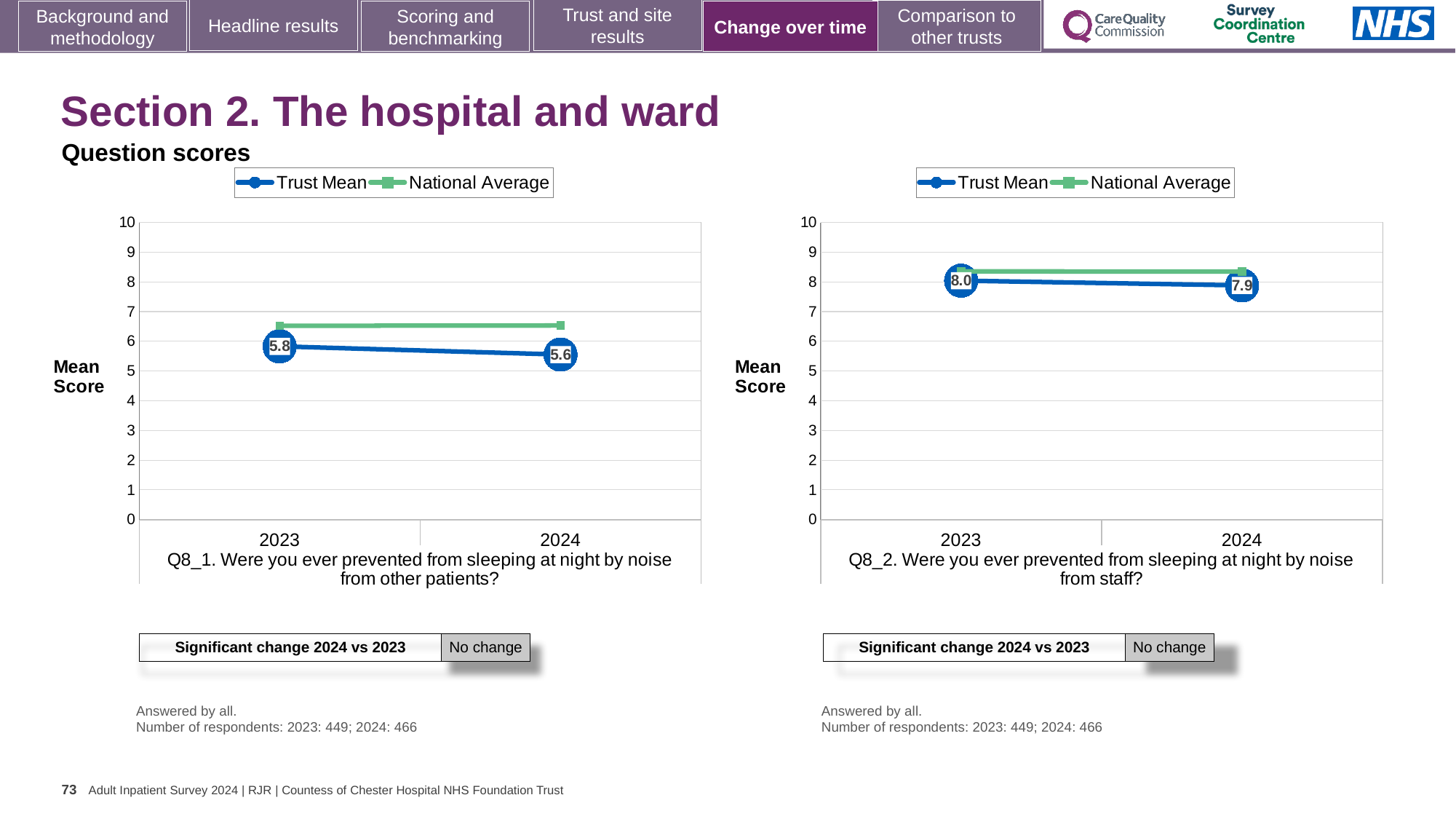
In the Q8_1 chart (left), is the National Average for 2024 greater or less than 6? greater In the Q8_1 chart (left), by how much did the Trust Mean change from 2023 to 2024? 0.2 In the Q8_2 chart (right), what is the Trust Mean score for 2024? 7.9 In the Q8_2 chart (right), which is larger in 2024, the Trust Mean or the National Average? National Average In the Q8_2 chart (right), does the Trust Mean rise or fall from 2023 to 2024? fall What kind of chart is the Q8_1 chart on the left? line chart How many series does the legend of the Q8_2 chart (right) list? 2 How many years are plotted on the x axis of the Q8_1 chart (left)? 2 What does the 'Significant change 2024 vs 2023' box below the Q8_2 chart (right) say? No change In the Q8_2 chart (right), what is the Trust Mean score for 2023? 8.0 In the Q8_1 chart (left), what is the Trust Mean score for 2024? 5.6 In the Q8_1 chart (left), what is the Trust Mean score for 2023? 5.8